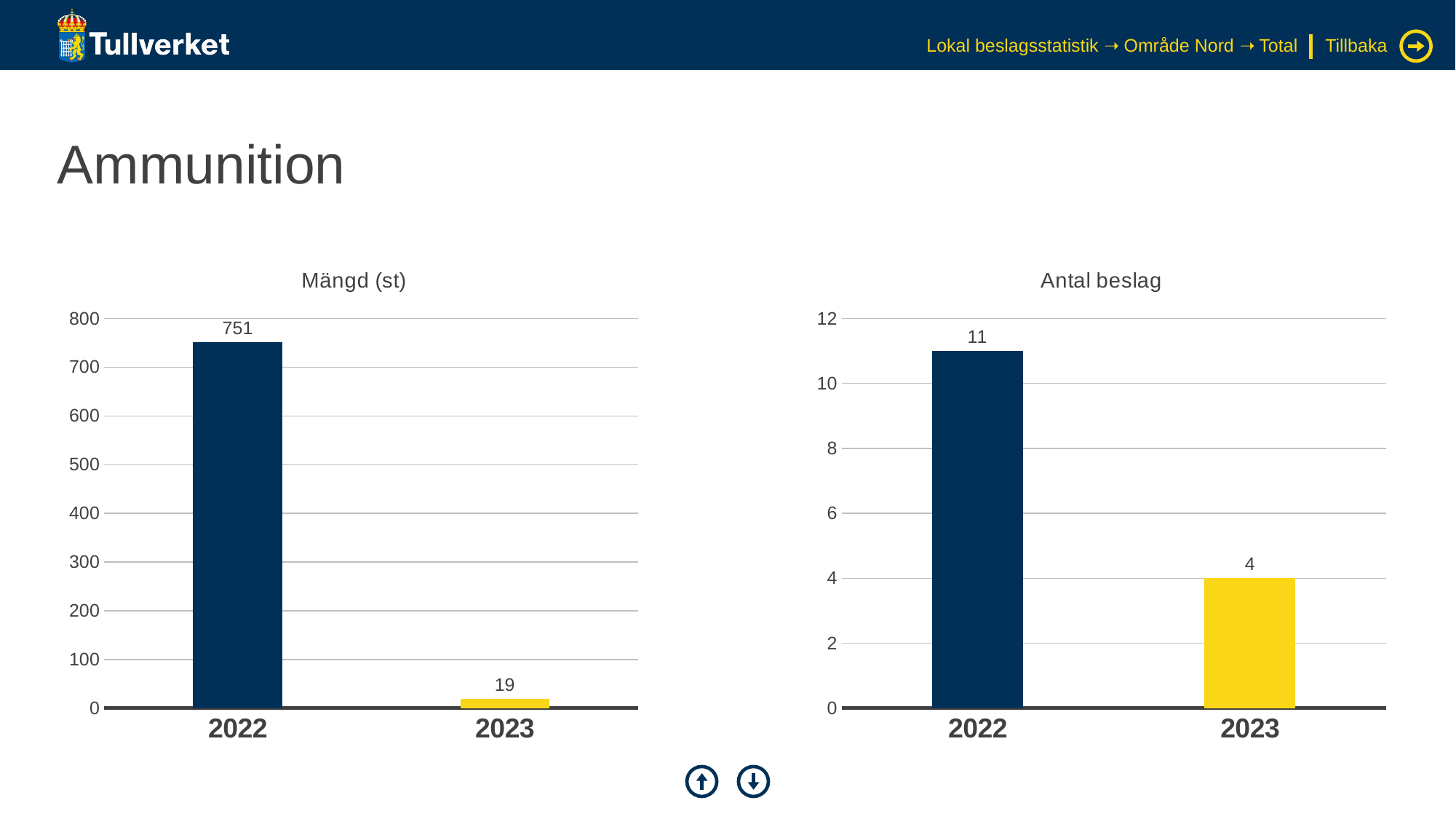
In the 'Mängd (st)' chart, what is the value for 2022? 751 In the 'Mängd (st)' chart, do the values rise or fall from 2022 to 2023? Fall In the 'Mängd (st)' chart, how many bars are shown? 2 In the 'Mängd (st)' chart, what is the difference between the 2022 and 2023 values? 732 In the 'Antal beslag' chart, what is the value for 2022? 11 In the 'Antal beslag' chart, which year has the lowest value? 2023 In the 'Antal beslag' chart, which is larger, the value for 2022 or 2023? 2022 What kind of chart is the 'Antal beslag' chart? Bar chart In the 'Mängd (st)' chart, what is the value for 2023? 19 In the 'Mängd (st)' chart, which year has the highest value? 2022 In the 'Antal beslag' chart, what is the value for 2023? 4 In the 'Antal beslag' chart, what is the difference between the 2022 and 2023 values? 7